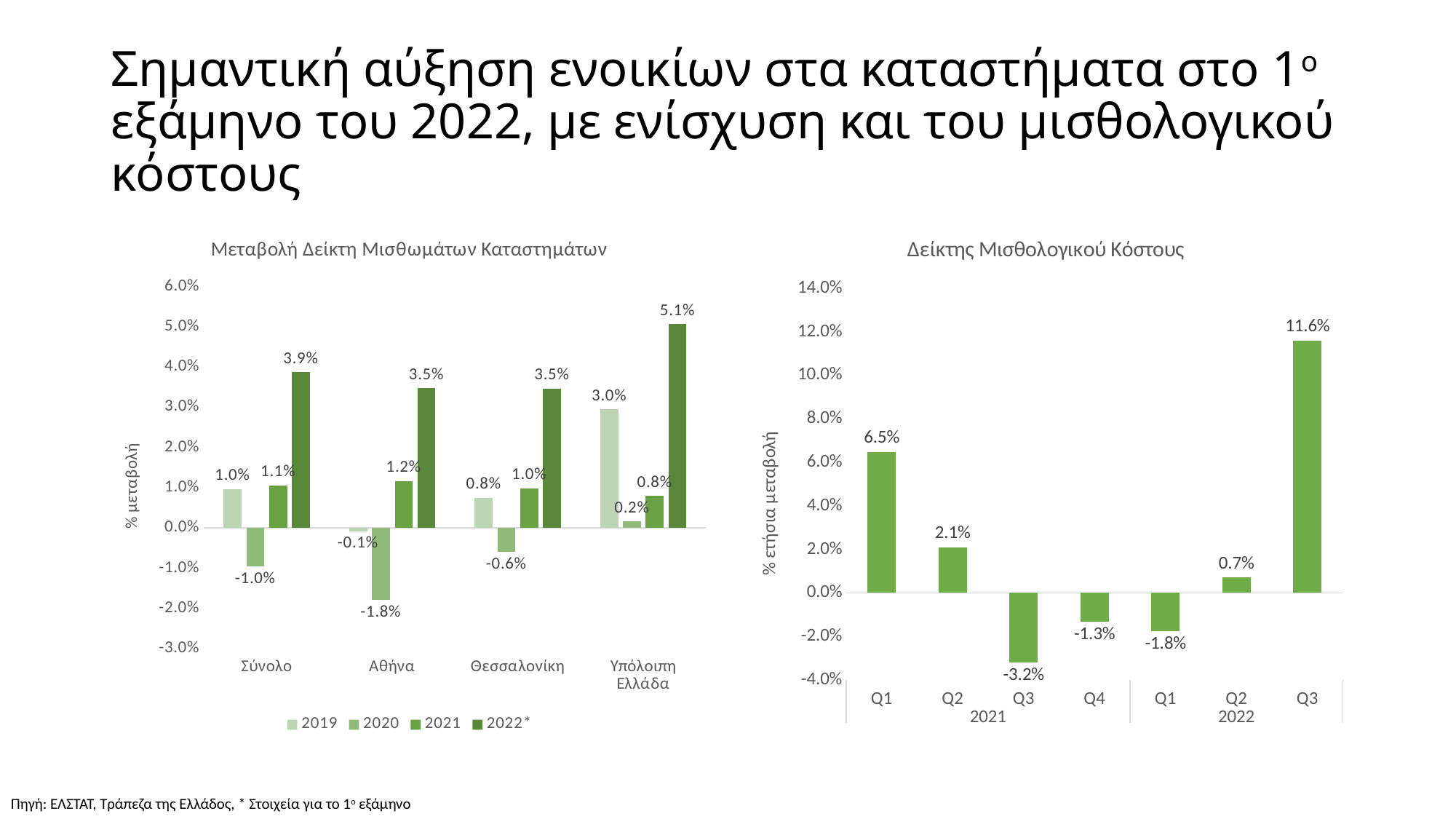
In the chart 'Δείκτης Μισθολογικού Κόστους', which quarter has the lowest value? Q3 2021 In the chart 'Μεταβολή Δείκτη Μισθωμάτων Καταστημάτων', what is the value for Σύνολο in 2022*? 3.9% In the chart 'Μεταβολή Δείκτη Μισθωμάτων Καταστημάτων', what is the difference between the 2022* and 2021 values for Σύνολο? 2.8% In the chart 'Μεταβολή Δείκτη Μισθωμάτων Καταστημάτων', how many categories are shown on the x axis? 4 In the chart 'Δείκτης Μισθολογικού Κόστους', what is the difference between Q1 2021 and Q2 2021? 4.4% In the chart 'Δείκτης Μισθολογικού Κόστους', is the value for Q4 2021 larger or smaller than the value for Q1 2022? larger In the chart 'Μεταβολή Δείκτη Μισθωμάτων Καταστημάτων', how many series does the legend list? 4 What kind of chart is 'Δείκτης Μισθολογικού Κόστους'? bar chart In the chart 'Μεταβολή Δείκτη Μισθωμάτων Καταστημάτων', which category has the highest 2022* value? Υπόλοιπη Ελλάδα In the chart 'Δείκτης Μισθολογικού Κόστους', what is the value for Q3 2022? 11.6% In the chart 'Μεταβολή Δείκτη Μισθωμάτων Καταστημάτων', what is the value for Αθήνα in 2020? -1.8% In the chart 'Μεταβολή Δείκτη Μισθωμάτων Καταστημάτων', which category has the lowest 2020 value? Αθήνα